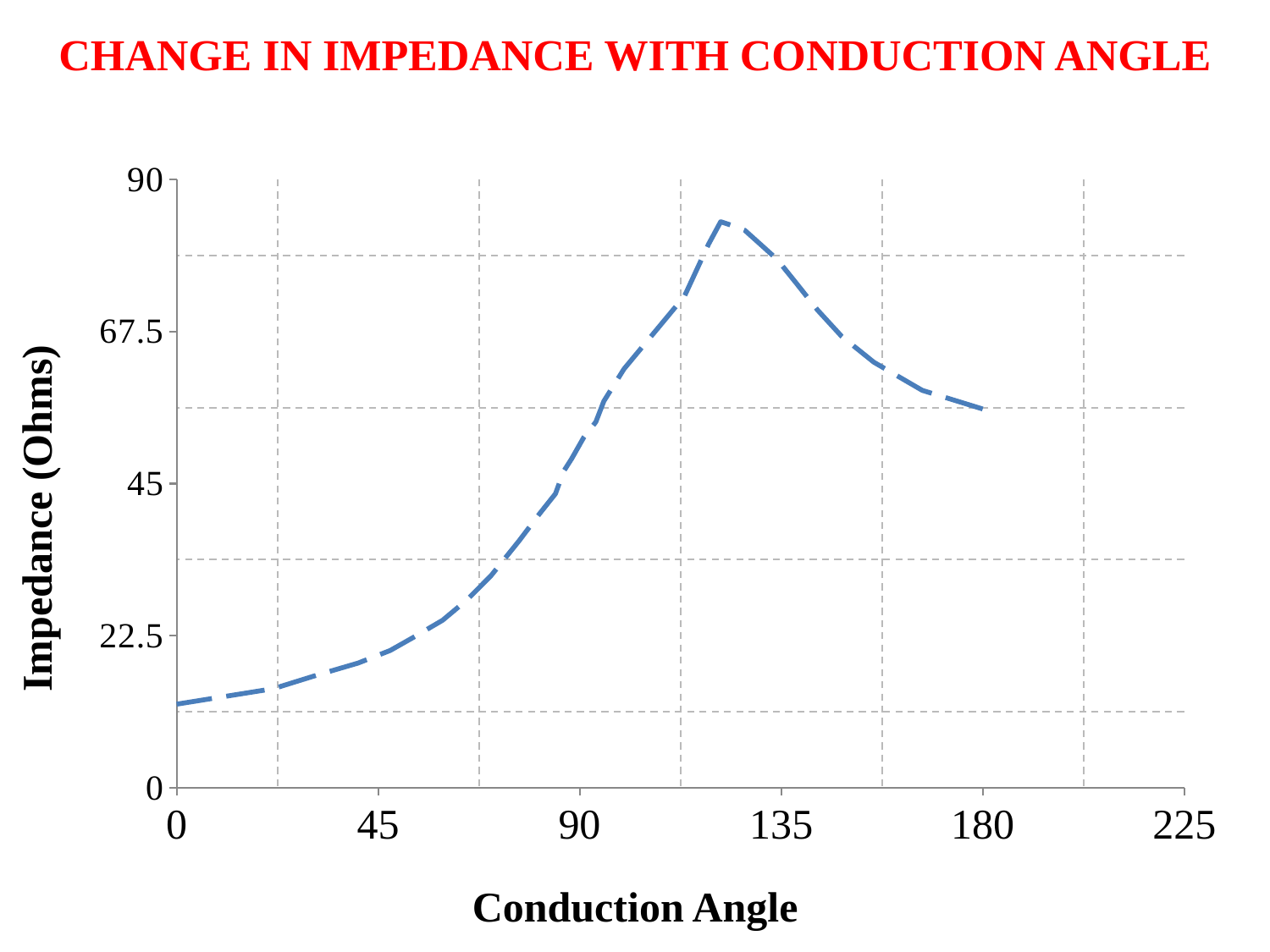
Which is larger, the impedance at a conduction angle of 45 or at 180? 180 What is the label of the vertical axis? Impedance (Ohms) Is the impedance at a conduction angle of 0 greater or less than 22.5? less Is the impedance at a conduction angle of 45 greater or less than 22.5? less Is the peak impedance on the chart greater or less than 90? less Does the impedance rise or fall as the conduction angle increases from 135 to 180? fall Does the impedance rise or fall as the conduction angle increases from 0 to 90? rise What is the title of the chart? CHANGE IN IMPEDANCE WITH CONDUCTION ANGLE What kind of chart is shown on the slide? line chart